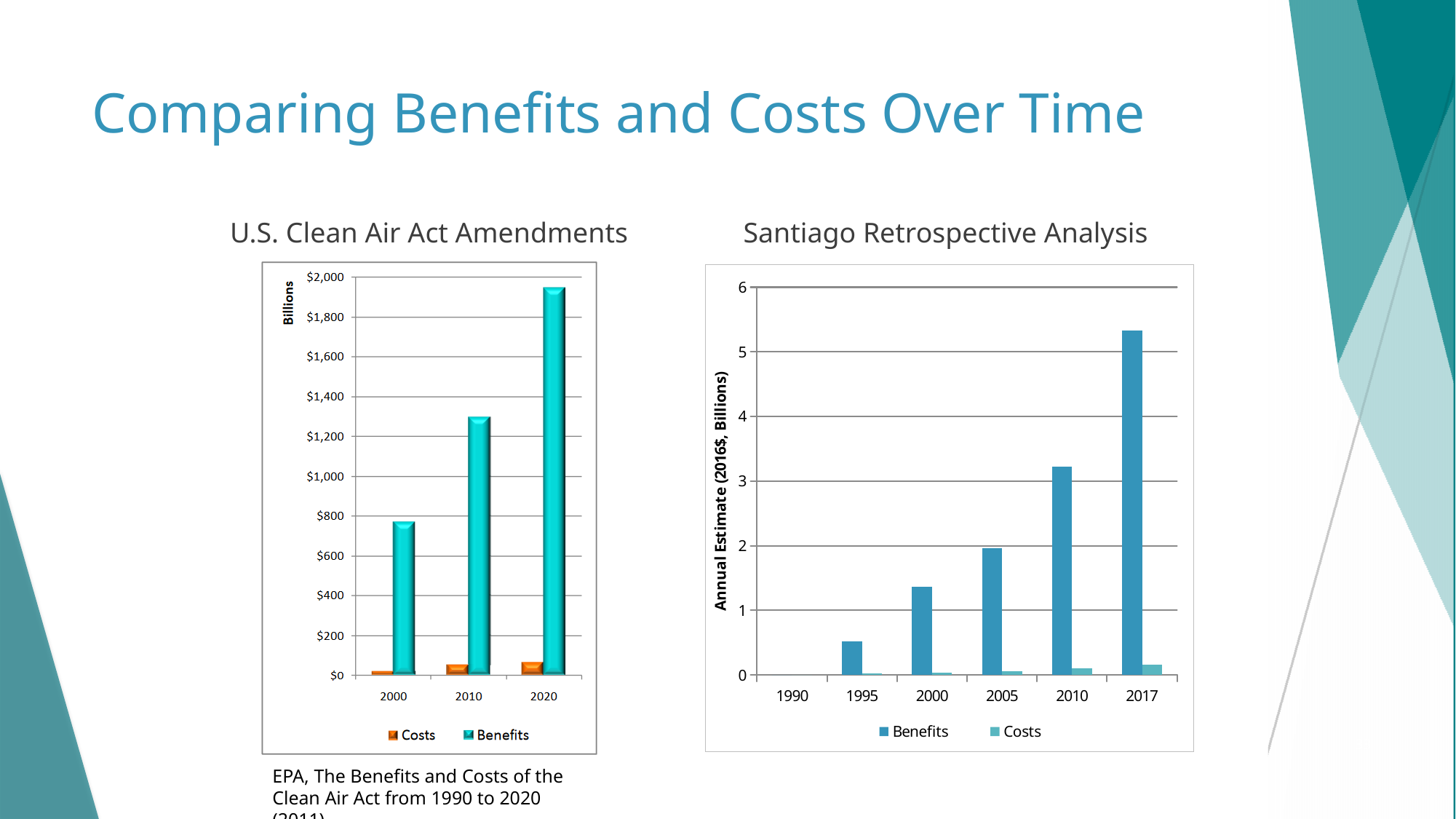
In the U.S. Clean Air Act Amendments chart, which year has the highest Benefits value? 2020 In the Santiago Retrospective Analysis chart, which year has the highest Benefits value? 2017 In the U.S. Clean Air Act Amendments chart, which is larger in 2020, Costs or Benefits? Benefits What kind of chart is the U.S. Clean Air Act Amendments chart? bar chart How many years are shown on the x axis of the Santiago Retrospective Analysis chart? 6 In the Santiago Retrospective Analysis chart, do the Benefits values rise or fall from 1990 to 2017? rise In the Santiago Retrospective Analysis chart, is the Benefits value for 1995 greater or less than 1? less How many series does the legend of the Santiago Retrospective Analysis chart list? 2 In the Santiago Retrospective Analysis chart, is the Benefits value for 2017 greater or less than 5? greater In the U.S. Clean Air Act Amendments chart, is the Benefits value for 2000 greater or less than $800? less How many years are shown on the x axis of the U.S. Clean Air Act Amendments chart? 3